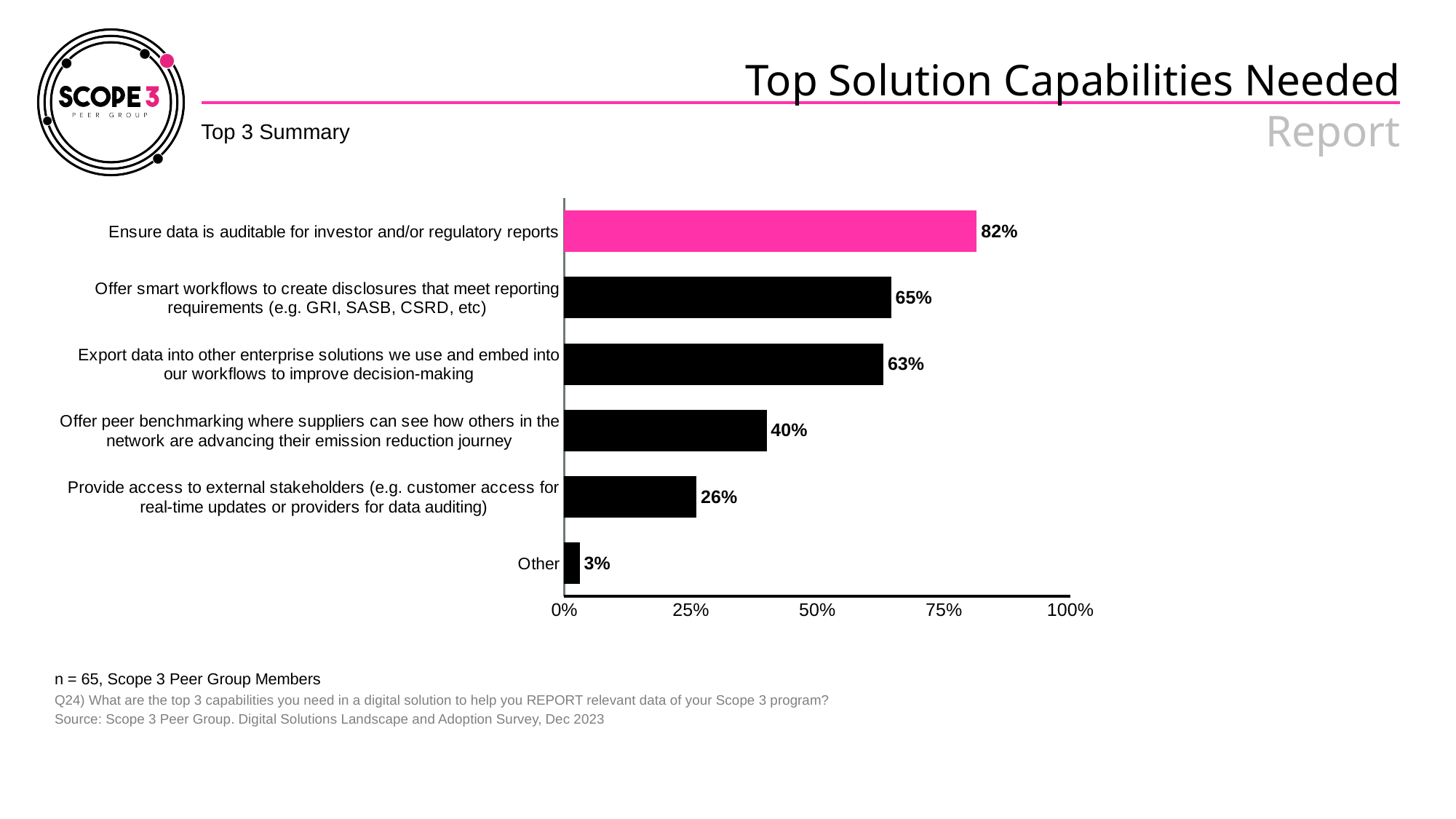
What percentage of respondents selected 'Ensure data is auditable for investor and/or regulatory reports'? 82% Which bar is coloured pink rather than black? Ensure data is auditable for investor and/or regulatory reports Which capability has the highest percentage? Ensure data is auditable for investor and/or regulatory reports Which category has the lowest percentage? Other What is the value shown for 'Other'? 3% What kind of chart is shown on the slide? Bar chart Is the value for 'Export data into other enterprise solutions we use and embed into our workflows to improve decision-making' greater or less than 50%? greater What is the difference between the value for 'Ensure data is auditable for investor and/or regulatory reports' and the value for 'Offer smart workflows to create disclosures that meet reporting requirements'? 17% What is the value for 'Offer peer benchmarking where suppliers can see how others in the network are advancing their emission reduction journey'? 40% Which is larger: the value for 'Offer peer benchmarking' or the value for 'Provide access to external stakeholders'? Offer peer benchmarking How many categories are shown in the chart? 6 What is the difference between the values for 'Provide access to external stakeholders' and 'Other'? 23%